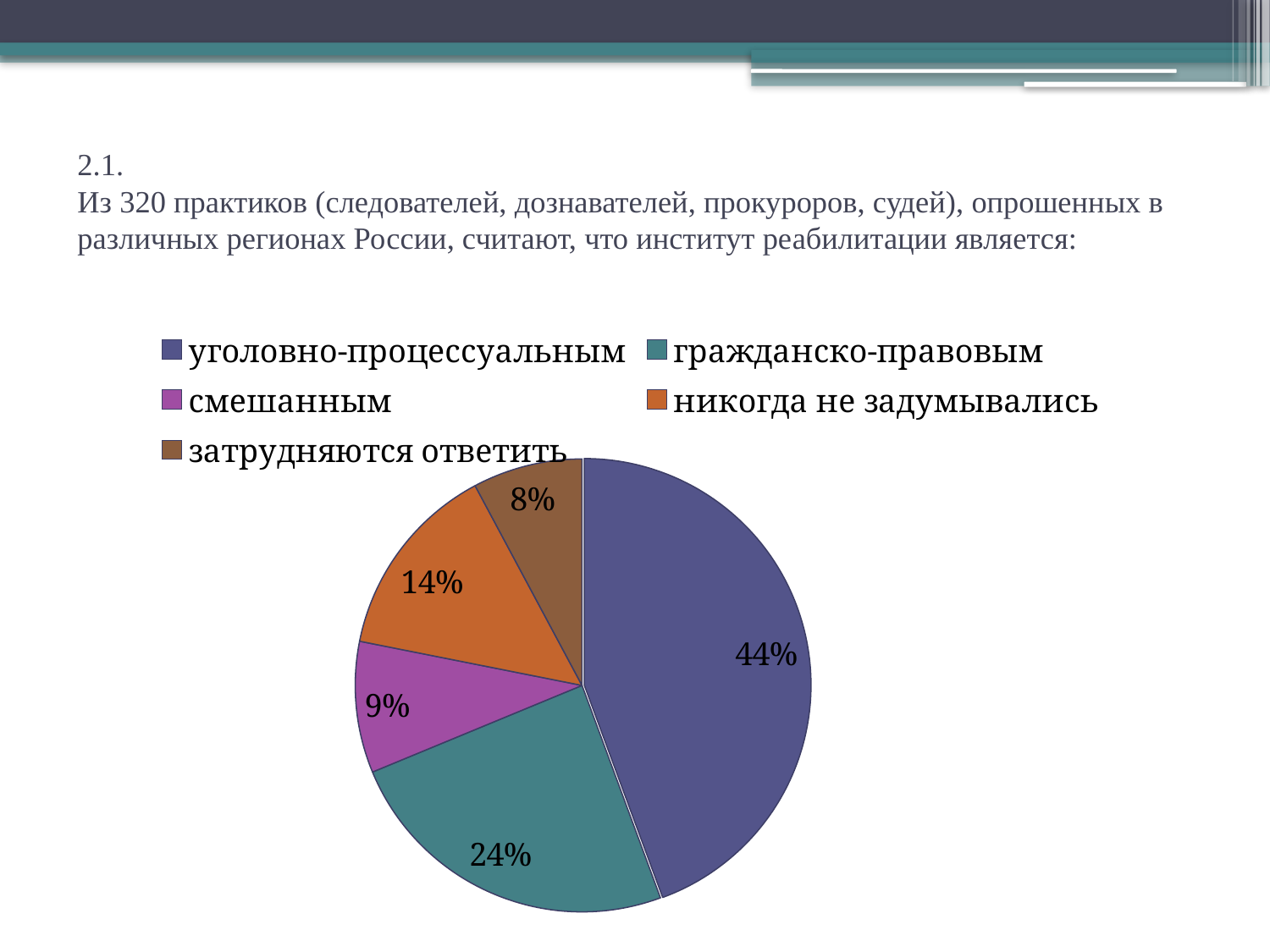
Which is larger: the share for никогда не задумывались or the share for смешанным? никогда не задумывались What share of respondents consider the institute of rehabilitation to be гражданско-правовым? 24% What percentage of respondents answered затрудняются ответить? 8% What is the difference in percentage points between уголовно-процессуальным and гражданско-правовым? 20 What colour is the slice for гражданско-правовым? teal What share of respondents consider the institute of rehabilitation to be уголовно-процессуальным? 44% What percentage of respondents answered смешанным? 9% How many categories does the pie chart show? 5 What percentage of respondents answered никогда не задумывались? 14% Which category has the smallest share of the pie? затрудняются ответить Which category has the largest share of the pie? уголовно-процессуальным What type of chart is shown on the slide? pie chart